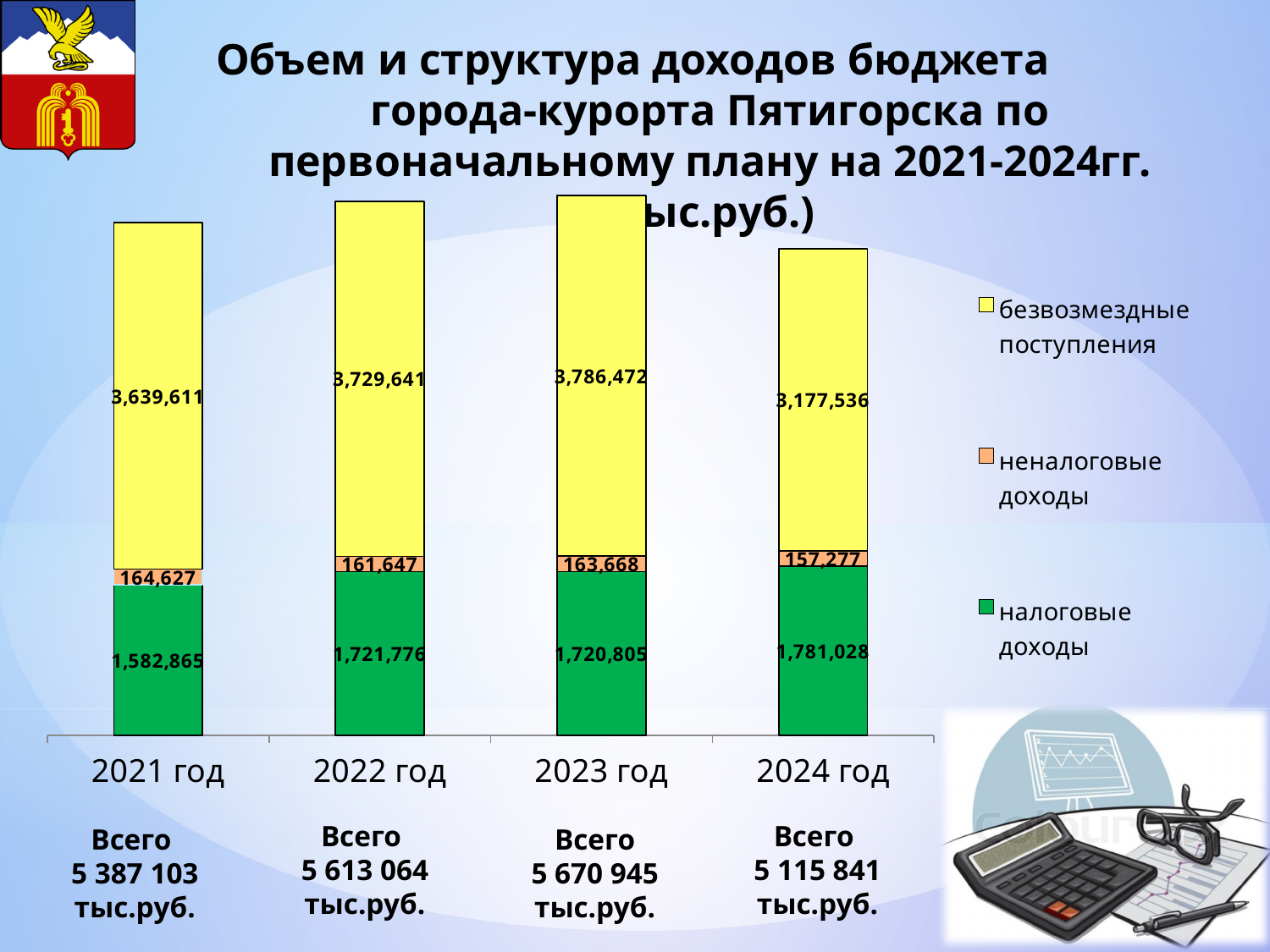
By how much do безвозмездные поступления in 2023 год exceed those in 2024 год? 608,936 What is the value of неналоговые доходы for 2024 год? 157,277 How many years are shown on the x axis? 4 What is the value of налоговые доходы for 2021 год? 1,582,865 In which year are неналоговые доходы the lowest? 2024 год Which colour represents налоговые доходы in the chart? Green What kind of chart is shown on the slide? Stacked bar chart Which year has larger налоговые доходы, 2021 год or 2024 год? 2024 год How many series does the legend list? 3 What is the value of безвозмездные поступления for 2023 год? 3,786,472 What is the total (Всего) for 2022 год? 5 613 064 тыс.руб. In which year are безвозмездные поступления the highest? 2023 год